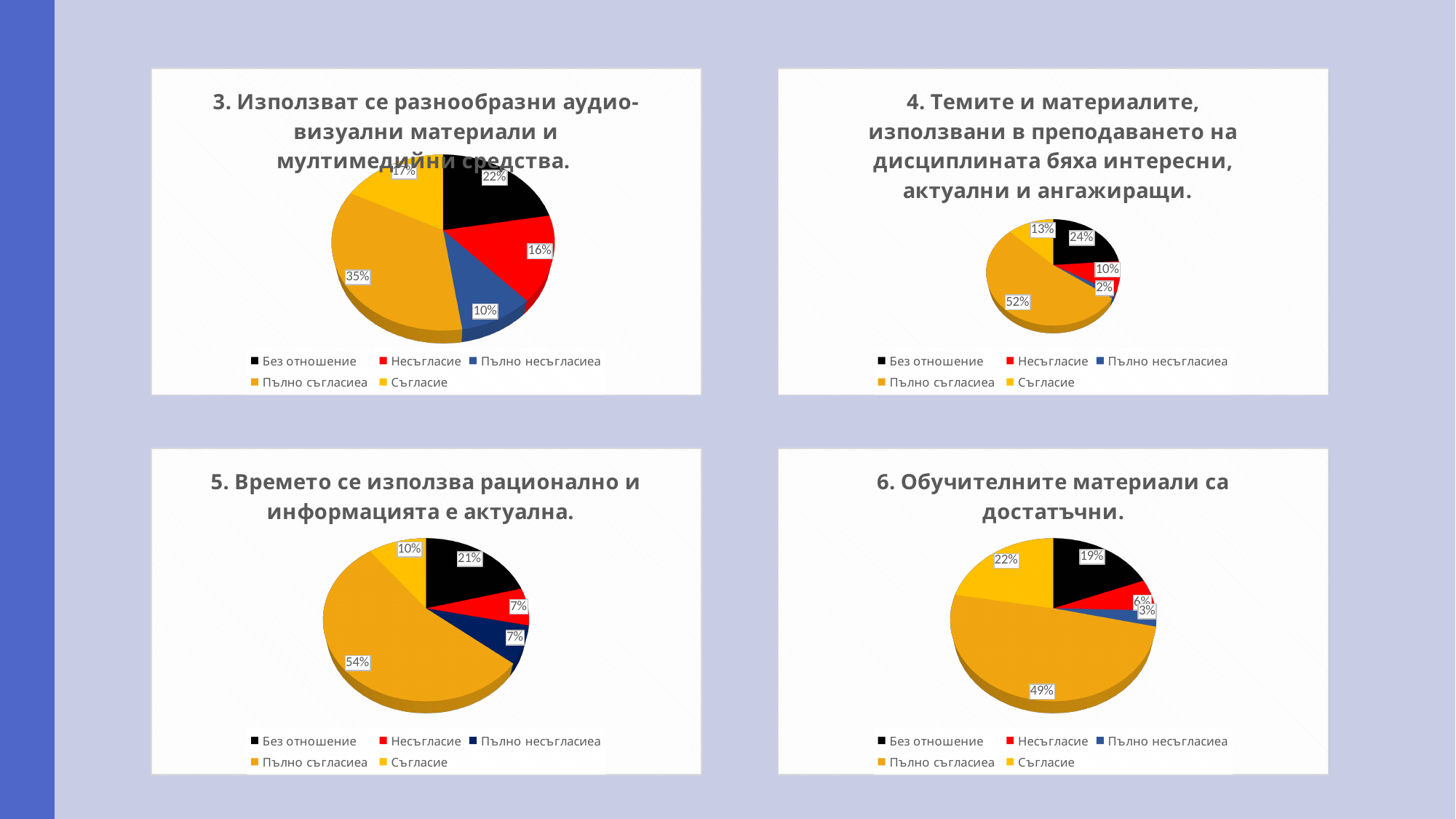
In the top-left chart (3. Използват се разнообразни аудио-визуални материали и мултимедийни средства.), which category has the smallest slice? Пълно несъгласиеа How many categories does the legend of the bottom-right chart (6. Обучителните материали са достатъчни.) list? 5 In the top-right chart (4. Темите и материалите, използвани в преподаването на дисциплината бяха интересни, актуални и ангажиращи.), what share does Пълно съгласиеа have? 52% In the bottom-left chart (5. Времето се използва рационално и информацията е актуална.), what is the value for Без отношение? 21% In the top-left chart (3. Използват се разнообразни аудио-визуални материали и мултимедийни средства.), what is the difference between Без отношение and Несъгласие? 6% What type of chart is the bottom-left chart (5. Времето се използва рационално и информацията е актуална.)? Pie chart In the top-right chart (4. Темите и материалите, използвани в преподаването на дисциплината бяха интересни, актуални и ангажиращи.), which is larger, Без отношение or Съгласие? Без отношение In the top-left chart (3. Използват се разнообразни аудио-визуални материали и мултимедийни средства.), what share does Пълно съгласиеа have? 35% In the top-right chart (4. Темите и материалите, използвани в преподаването на дисциплината бяха интересни, актуални и ангажиращи.), what is the value for Пълно несъгласиеа? 2% In the bottom-right chart (6. Обучителните материали са достатъчни.), what share does Съгласие have? 22% In the bottom-right chart (6. Обучителните материали са достатъчни.), what is the difference between Пълно съгласиеа and Без отношение? 30% In the bottom-left chart (5. Времето се използва рационално и информацията е актуална.), which category has the largest slice? Пълно съгласиеа